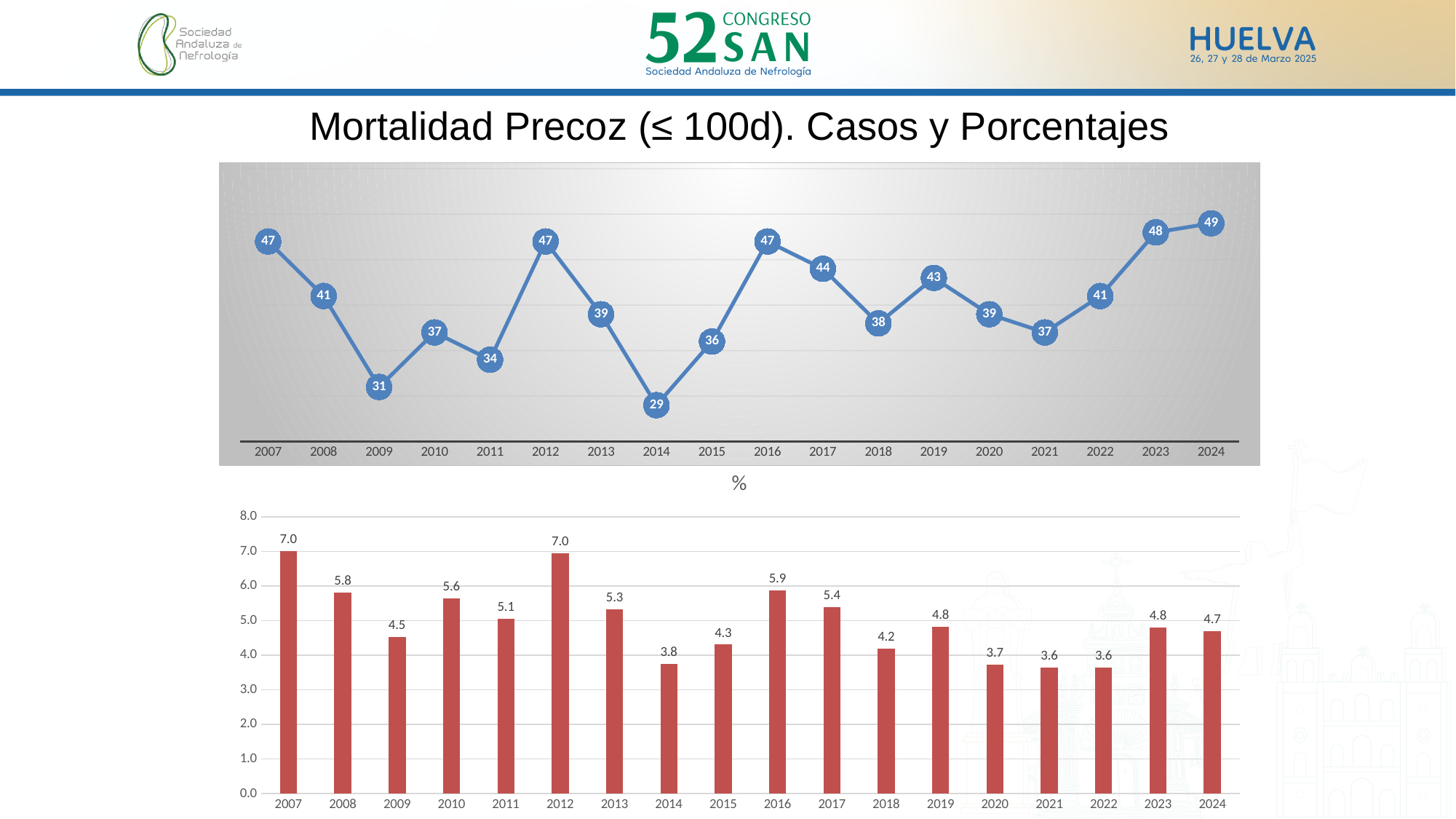
In the top line chart, how many years are plotted along the x axis? 18 What is the title of the slide above the charts? Mortalidad Precoz (≤ 100d). Casos y Porcentajes In the bottom bar chart (%), what is the value for 2024? 4.7 In the bottom bar chart (%), what is the difference between the values for 2007 and 2021? 3.4 In the bottom bar chart (%), what is the value for 2016? 5.9 In the top line chart, which year has the highest value? 2024 In the bottom bar chart (%), which is larger, the value for 2010 or the value for 2011? 2010 What kind of chart is the top chart on the slide? line chart What kind of chart is the bottom chart on the slide? bar chart In the top line chart, what is the difference between the values for 2012 and 2009? 16 In the top line chart, which year has the lowest value? 2014 In the top line chart, what is the value for 2014? 29